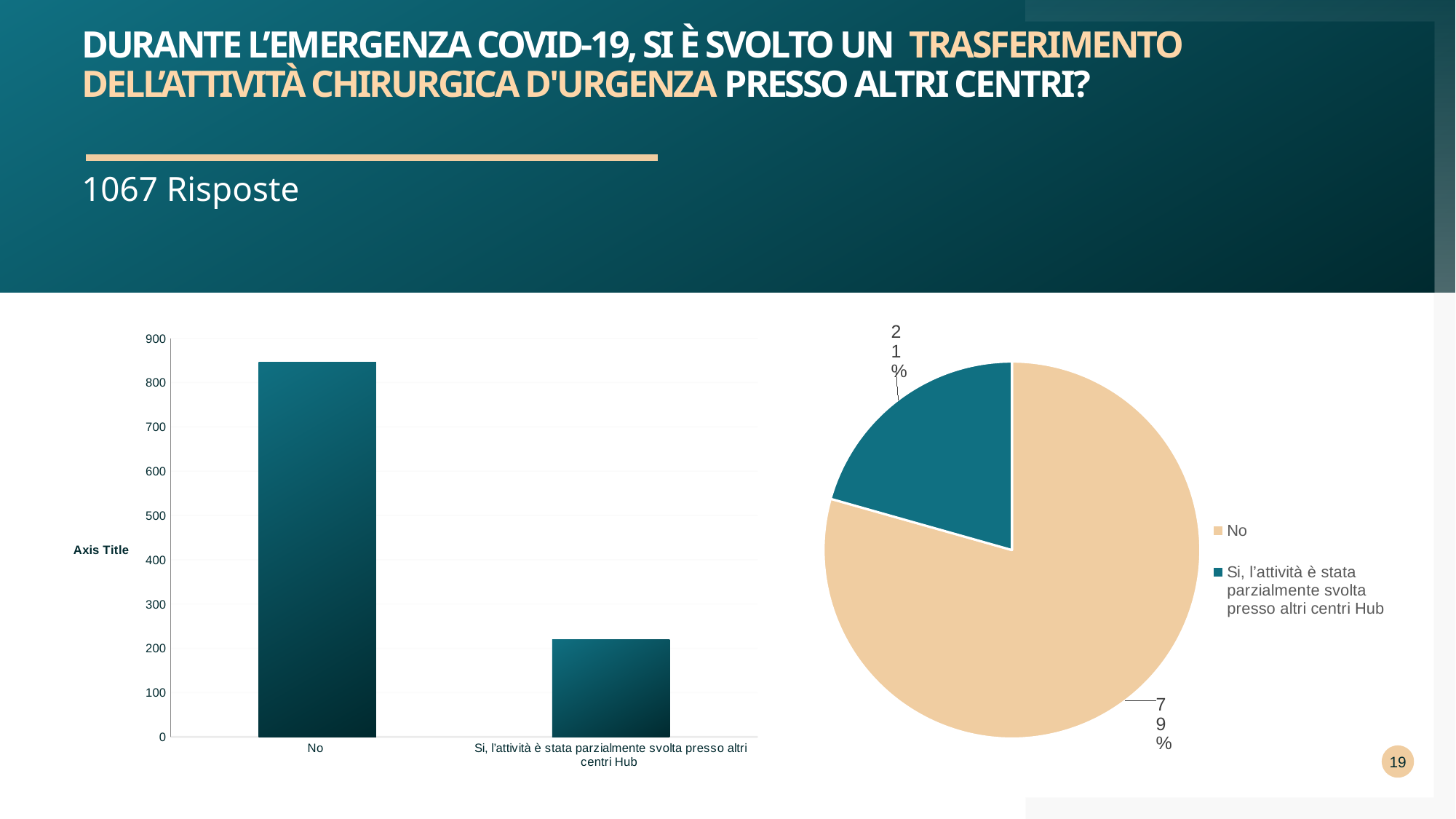
In the pie chart on the right, how many entries does the legend list? 2 In the pie chart on the right, what share does the No slice have? 79% In the pie chart on the right, what share does the 'Si, l'attività è stata parzialmente svolta presso altri centri Hub' slice have? 21% In the bar chart on the left, which category has the lowest value? Si, l'attività è stata parzialmente svolta presso altri centri Hub What kind of chart is on the right side of the slide? pie chart What kind of chart is on the left side of the slide? bar chart In the bar chart on the left, is the value for No greater or less than 800? greater In the bar chart on the left, how many categories are shown on the x axis? 2 In the bar chart on the left, which category has the highest value? No In the pie chart on the right, what is the difference in percentage points between the No slice and the Si slice? 58 In the bar chart on the left, is the value for 'Si, l'attività è stata parzialmente svolta presso altri centri Hub' greater or less than 200? greater In the bar chart on the left, is the value for 'Si, l'attività è stata parzialmente svolta presso altri centri Hub' greater or less than 300? less